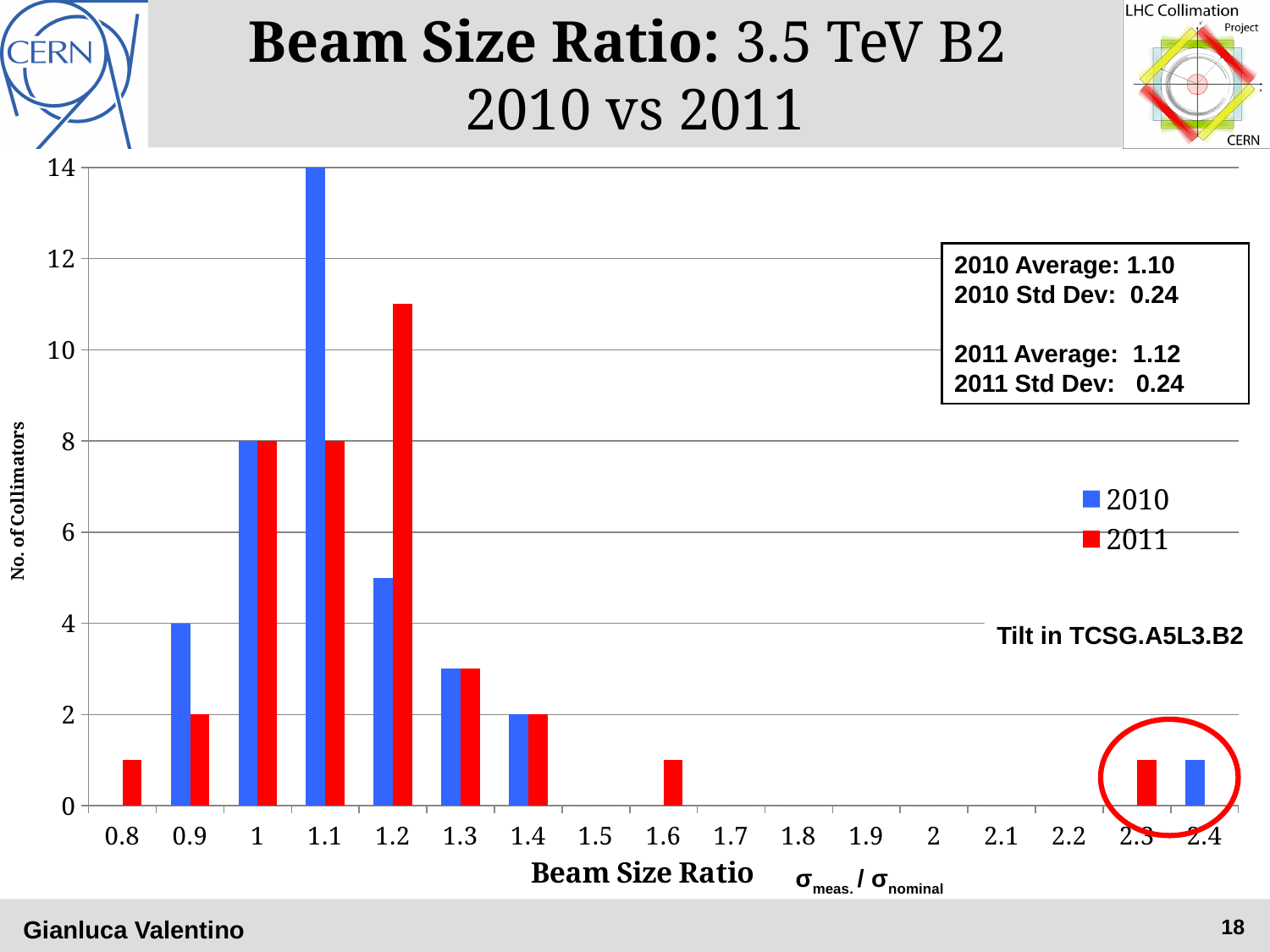
At which beam size ratio is the 2011 count highest? 1.2 How many series does the legend list? 2 What is the number of collimators for 2011 at a beam size ratio of 0.9? 2 What is the number of collimators for 2010 at a beam size ratio of 1.1? 14 What kind of chart is shown on the slide? bar chart Is the 2011 value at a beam size ratio of 1.2 greater or less than 10? greater At a beam size ratio of 1.2, which series has the larger value, 2010 or 2011? 2011 What is the difference between the 2010 values at beam size ratios 1.1 and 1? 6 What is the number of collimators for 2010 at a beam size ratio of 0.9? 4 What is the number of collimators for 2010 at a beam size ratio of 1? 8 At which beam size ratio is the 2010 count highest? 1.1 What is the title of the y axis? No. of Collimators